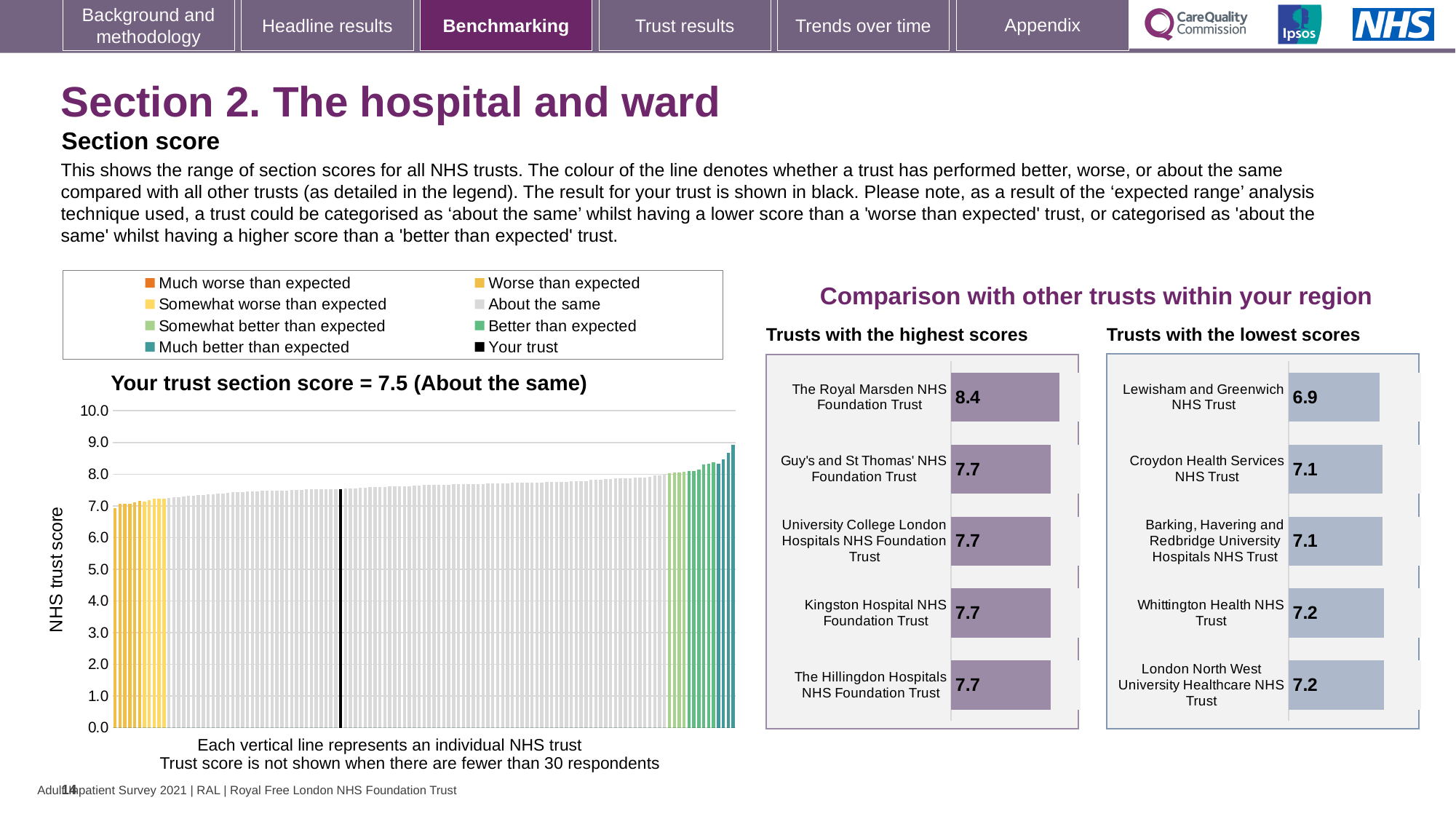
In the 'Trusts with the highest scores' chart, what is the difference between the scores of The Royal Marsden NHS Foundation Trust and Guy's and St Thomas' NHS Foundation Trust? 0.7 What kind of chart is the main chart on the left showing NHS trust scores? Bar chart In the 'Trusts with the highest scores' chart, what is the score for The Royal Marsden NHS Foundation Trust? 8.4 In the main chart on the left, do the trust scores rise or fall from left to right? Rise How many trusts are listed in the 'Trusts with the highest scores' chart? 5 In the 'Trusts with the highest scores' chart, which trust has the highest score? The Royal Marsden NHS Foundation Trust How many entries does the legend above the main chart on the left list? 8 In the 'Trusts with the lowest scores' chart, which trust has the lowest score? Lewisham and Greenwich NHS Trust In the 'Trusts with the lowest scores' chart, which has the higher score: Whittington Health NHS Trust or Croydon Health Services NHS Trust? Whittington Health NHS Trust In the main chart on the left, what is your trust's section score? 7.5 In the 'Trusts with the lowest scores' chart, what is the difference between the scores of Croydon Health Services NHS Trust and Lewisham and Greenwich NHS Trust? 0.2 In the 'Trusts with the lowest scores' chart, what is the score for Lewisham and Greenwich NHS Trust? 6.9